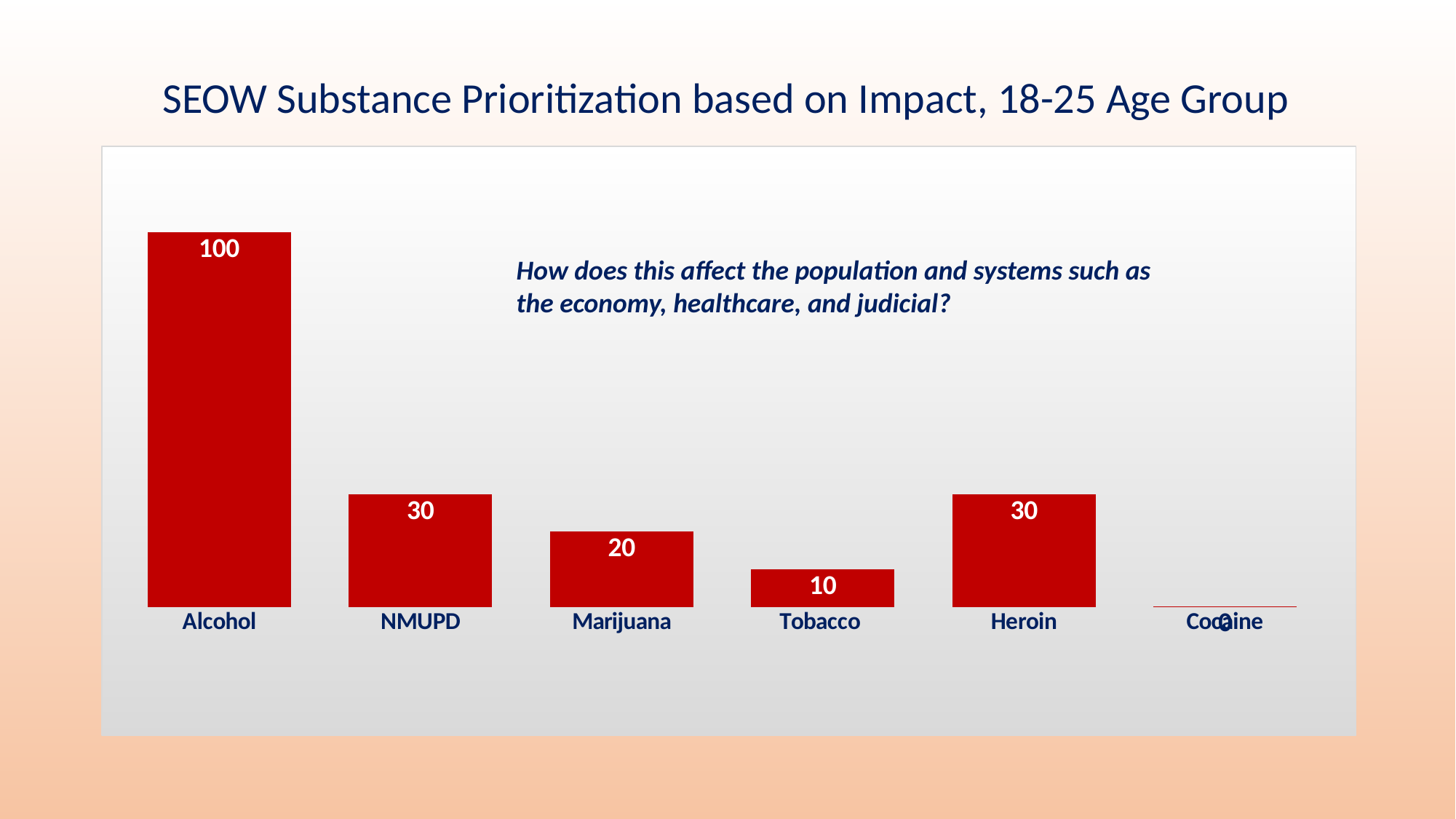
What is the value for Marijuana? 20 Which category has the lowest value? Cocaine Which category has the highest value? Alcohol What is the value for Cocaine? 0 What kind of chart is shown on the slide? Bar chart Which is larger, the value for Marijuana or the value for Tobacco? Marijuana What is the value for NMUPD? 30 How many categories are shown in the chart? 6 What is the value for Heroin? 30 What is the value for Tobacco? 10 What is the difference between the values for Alcohol and Heroin? 70 What is the value for Alcohol? 100